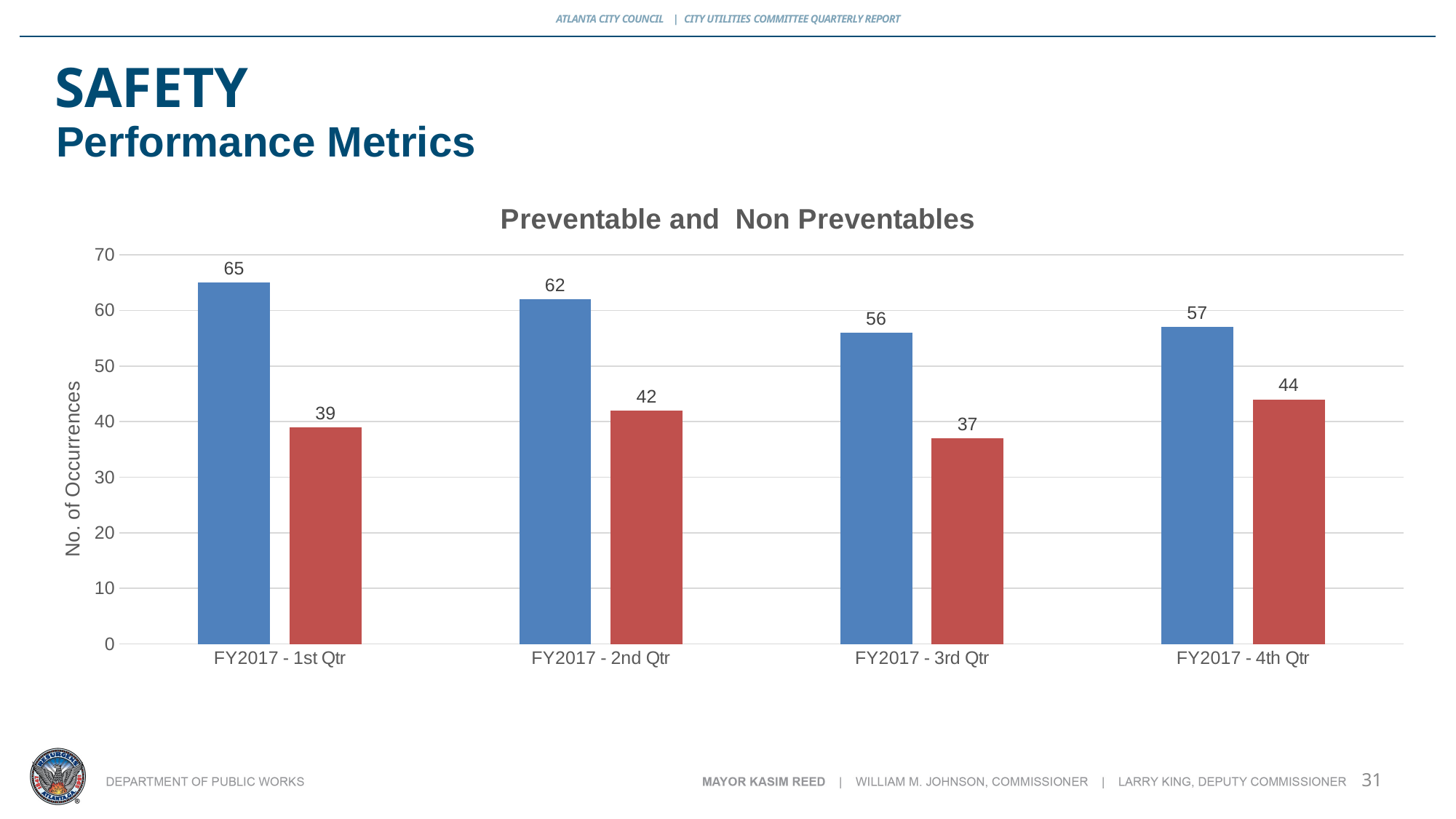
What is the value of the red bar for FY2017 - 4th Qtr? 44 In which quarter is the red bar lowest? FY2017 - 3rd Qtr How many quarters are shown on the x axis? 4 Which is larger: the red bar for FY2017 - 2nd Qtr or the red bar for FY2017 - 4th Qtr? FY2017 - 4th Qtr What is the difference between the blue bar and the red bar for FY2017 - 2nd Qtr? 20 What is the value of the red bar for FY2017 - 3rd Qtr? 37 What is the title of the chart? Preventable and Non Preventables Do the blue bars rise or fall from FY2017 - 1st Qtr to FY2017 - 3rd Qtr? fall What is the value of the blue bar for FY2017 - 1st Qtr? 65 In which quarter is the blue bar highest? FY2017 - 1st Qtr Is the value of the blue bar for FY2017 - 3rd Qtr greater or less than 60? less What kind of chart is shown on the slide? bar chart